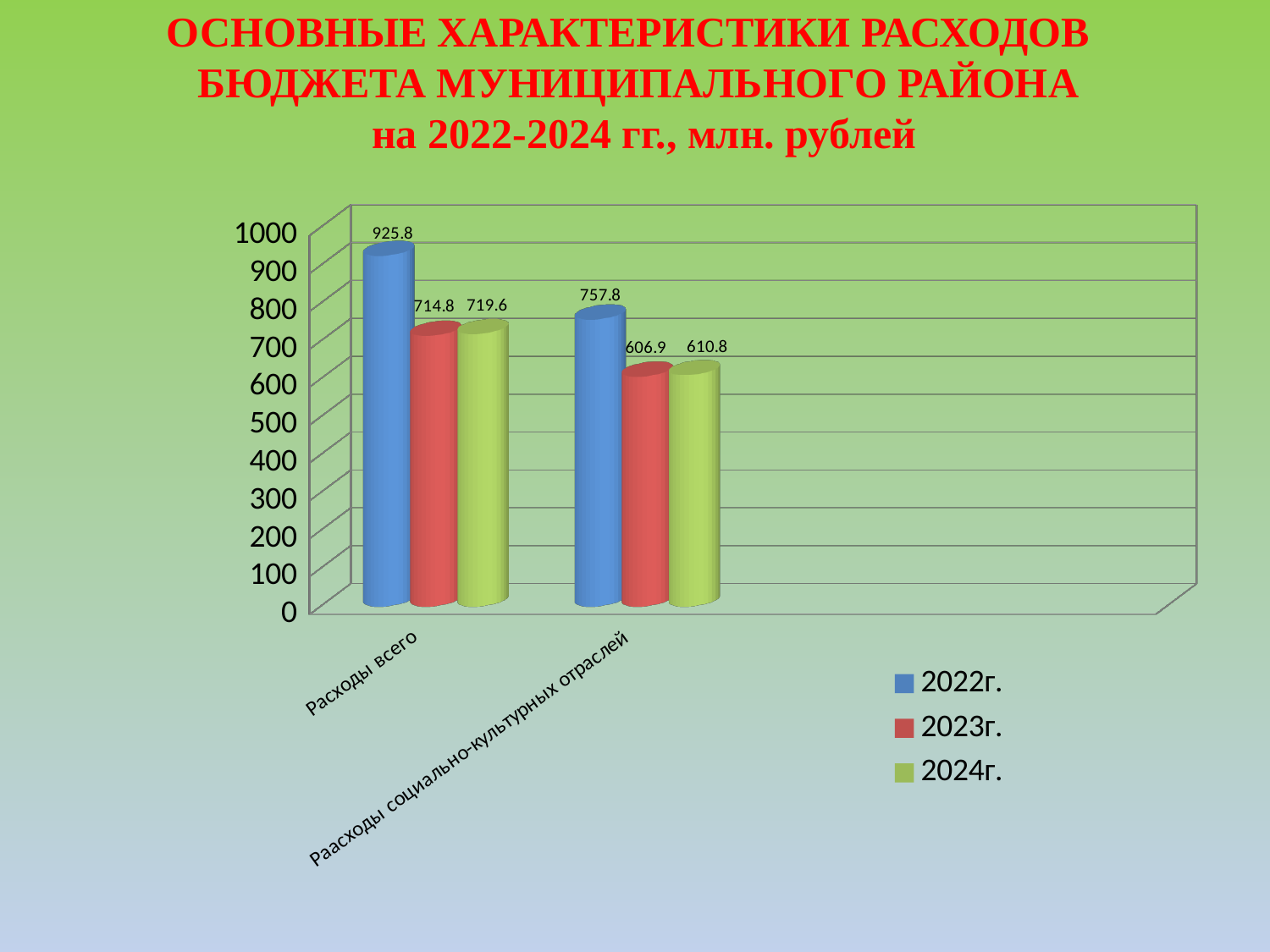
How many series does the legend list? 3 What is the difference between the 2024г. and 2023г. values in the category 'Раасходы социально-культурных отраслей'? 3.9 Which is larger: the 2022г. value for 'Расходы всего' or the 2022г. value for 'Раасходы социально-культурных отраслей'? Расходы всего What is the value for 2022г. in the category 'Раасходы социально-культурных отраслей'? 757.8 What is the difference between the 2022г. and 2023г. values in the category 'Расходы всего'? 211 What is the value for 2022г. in the category 'Расходы всего'? 925.8 Which year has the highest value in the category 'Расходы всего'? 2022г. What is the value for 2023г. in the category 'Раасходы социально-культурных отраслей'? 606.9 What is the value for 2024г. in the category 'Расходы всего'? 719.6 Which year has the lowest value in the category 'Раасходы социально-культурных отраслей'? 2023г. How many categories are shown on the x axis of the chart? 2 What kind of chart is shown on the slide? Bar chart